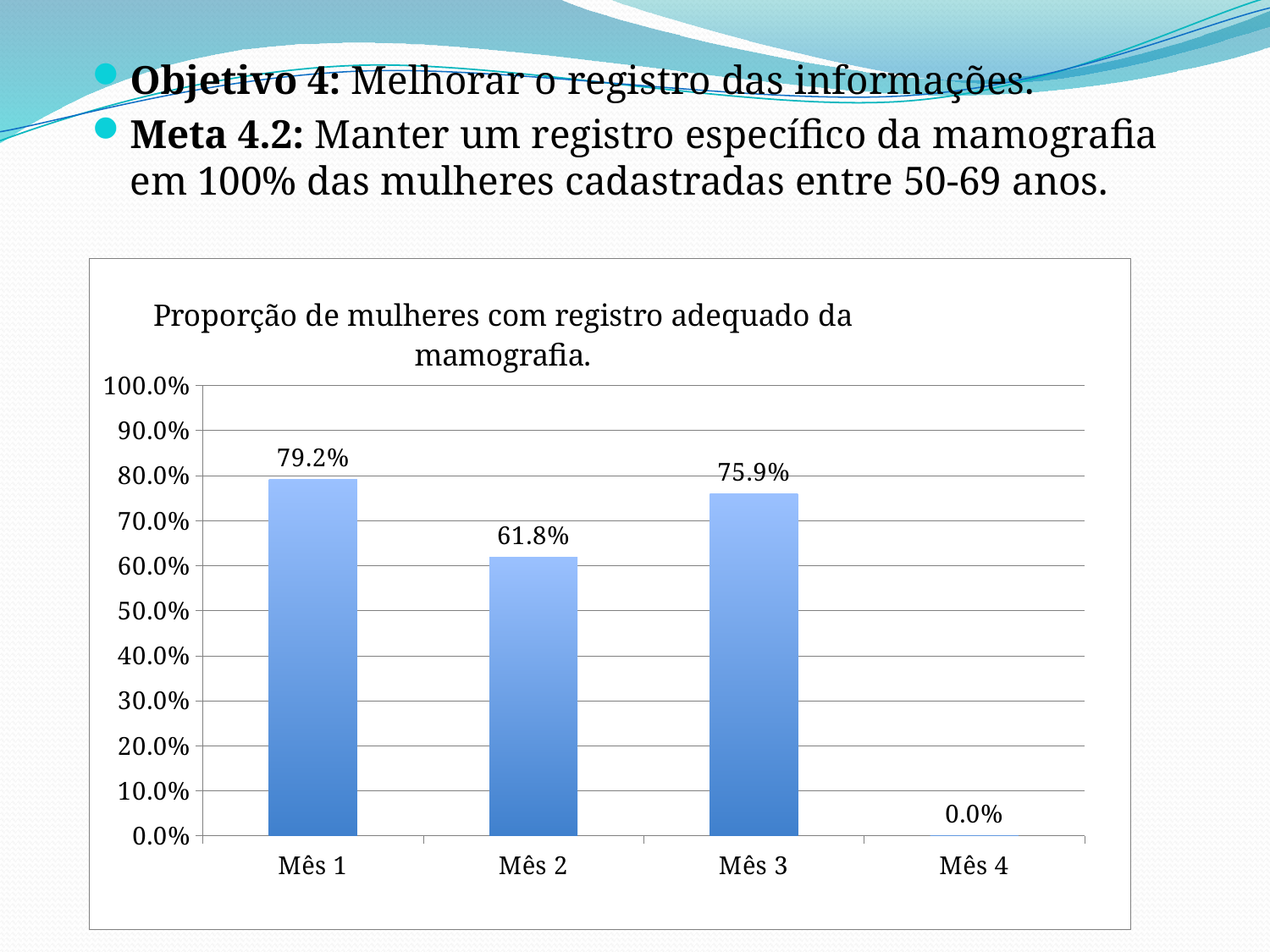
What is the value for Mês 1? 79.2% Is the value for Mês 2 greater or less than 70.0%? less Which month has the lowest value? Mês 4 What is the value for Mês 2? 61.8% How many months are shown on the x axis? 4 What is the title of the chart? Proporção de mulheres com registro adequado da mamografia. Which month has the highest value? Mês 1 What kind of chart is shown on the slide? bar chart Which is larger, the value for Mês 2 or the value for Mês 3? Mês 3 What is the value for Mês 3? 75.9% What is the difference between the values for Mês 1 and Mês 2? 17.4% What is the value for Mês 4? 0.0%